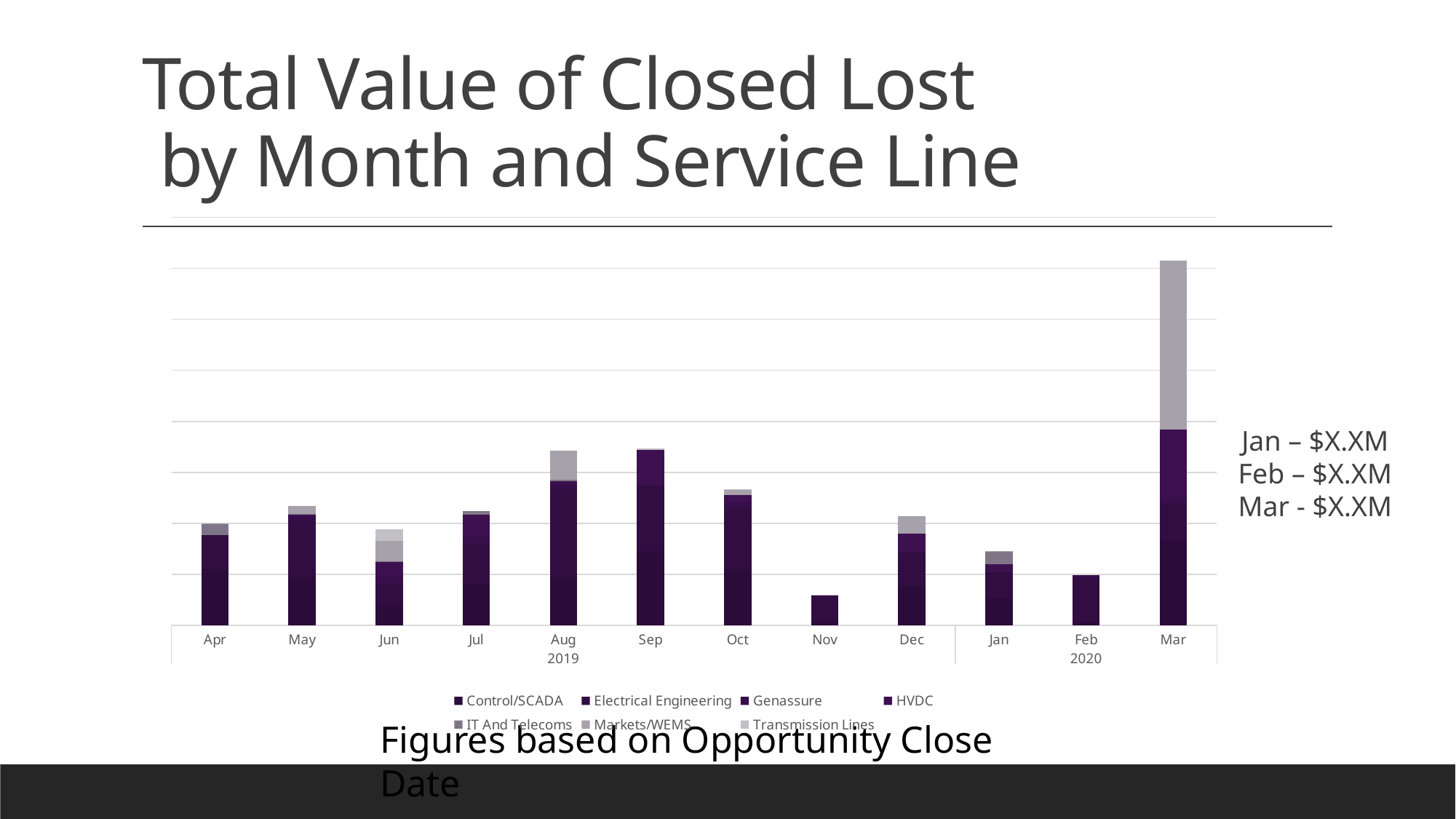
Which month has the larger total closed lost value, Aug 2019 or Nov 2019? Aug 2019 How many service lines does the chart's legend list? 7 Which month has the larger total closed lost value, Feb 2020 or Nov 2019? Feb 2020 Which month has the tallest stacked bar in the chart? Mar 2020 Which month has the larger total closed lost value, Mar 2020 or Sep 2019? Mar 2020 Which service line is listed first in the chart's legend? Control/SCADA What is the title of the chart on the slide? Total Value of Closed Lost by Month and Service Line Which month has the shortest stacked bar in the chart? Nov 2019 How many months are plotted along the x axis of the chart? 12 Which two years are shown on the x axis of the chart? 2019 and 2020 What kind of chart is shown on the slide? Stacked bar chart